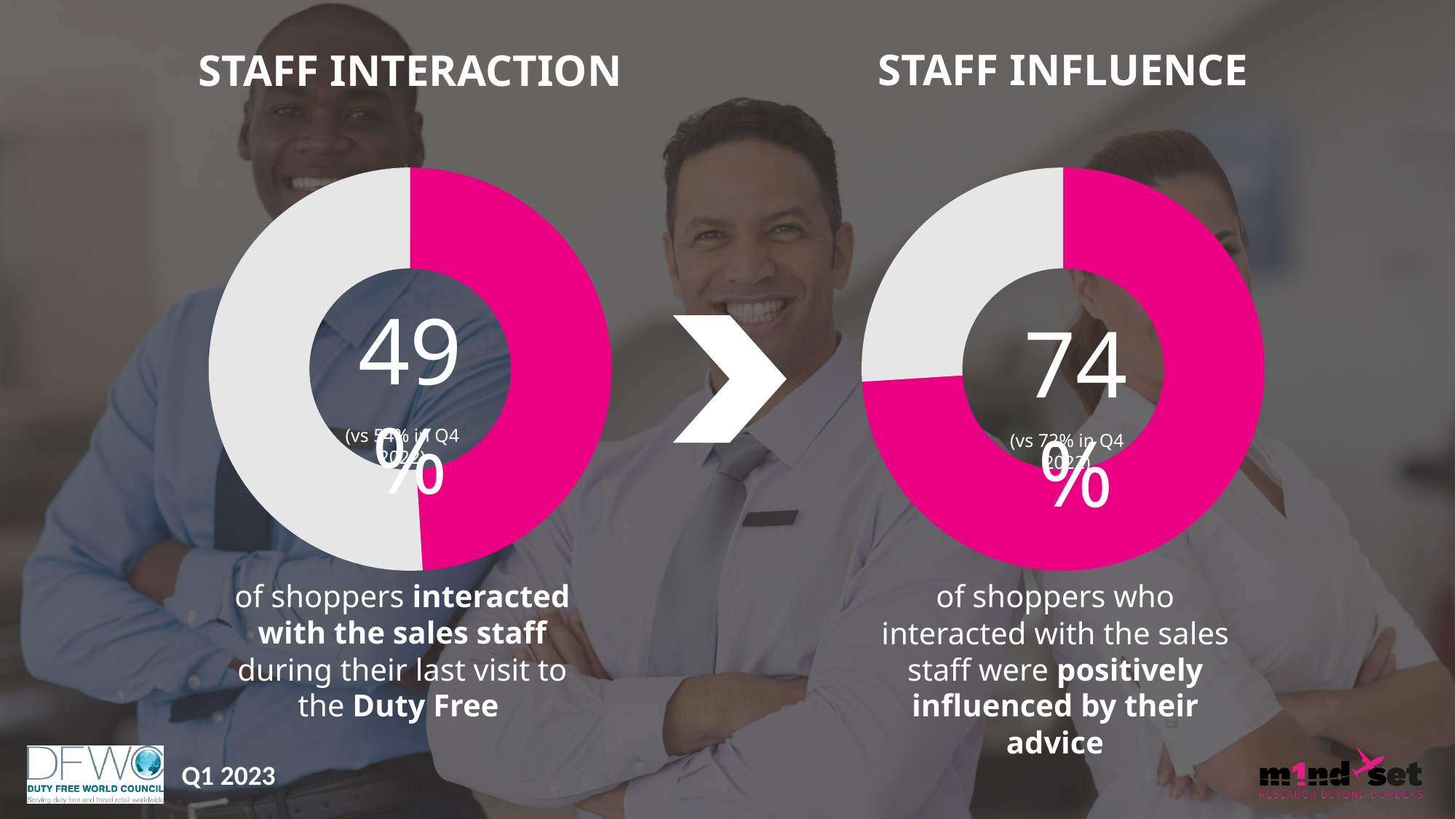
Is the value shown in the STAFF INFLUENCE chart greater or less than 70%? greater What kind of chart is used under the STAFF INFLUENCE heading? Donut chart Which quarter does the slide report data for, as shown in the bottom-left corner? Q1 2023 In the STAFF INTERACTION chart, what percentage of shoppers interacted with the sales staff during their last visit to the Duty Free? 49% Is the value shown in the STAFF INTERACTION chart greater or less than 50%? less What kind of chart is used under the STAFF INTERACTION heading? Donut chart In the STAFF INFLUENCE chart, what percentage of shoppers who interacted with the sales staff were positively influenced by their advice? 74% In the STAFF INTERACTION chart, what share of the donut is filled in pink? 49% Which chart shows the larger value, STAFF INTERACTION or STAFF INFLUENCE? STAFF INFLUENCE How many donut charts are shown on the slide? 2 What colour is used for the highlighted segment in both donut charts? Pink What is the difference between the value in the STAFF INFLUENCE chart and the value in the STAFF INTERACTION chart? 25 percentage points